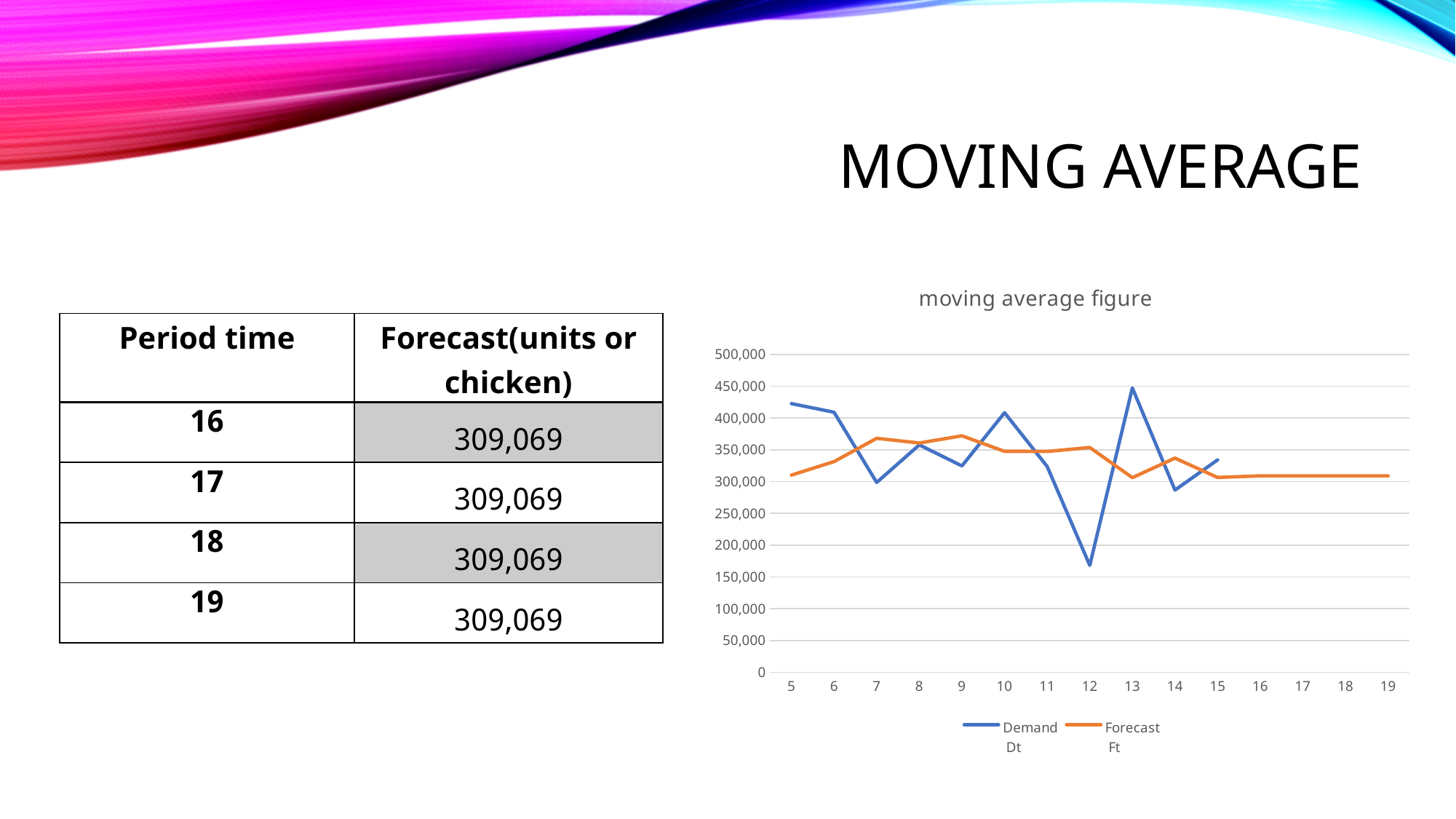
What are the two series named in the chart legend? Demand Dt and Forecast Ft What kind of chart is shown on the slide? line chart Is the Demand Dt value at period 13 greater or less than 400,000? greater How many periods are shown on the x axis of the chart? 15 At which period does the Demand Dt series reach its lowest value? 12 At period 12, which series has the larger value, Demand Dt or Forecast Ft? Forecast Ft Is the Demand Dt value at period 12 greater or less than 200,000? less What is the title of the chart? moving average figure At period 5, which series has the larger value, Demand Dt or Forecast Ft? Demand Dt Is the Forecast Ft value at period 7 greater or less than 350,000? greater How many series does the chart legend list? 2 At which period does the Demand Dt series reach its highest value? 13